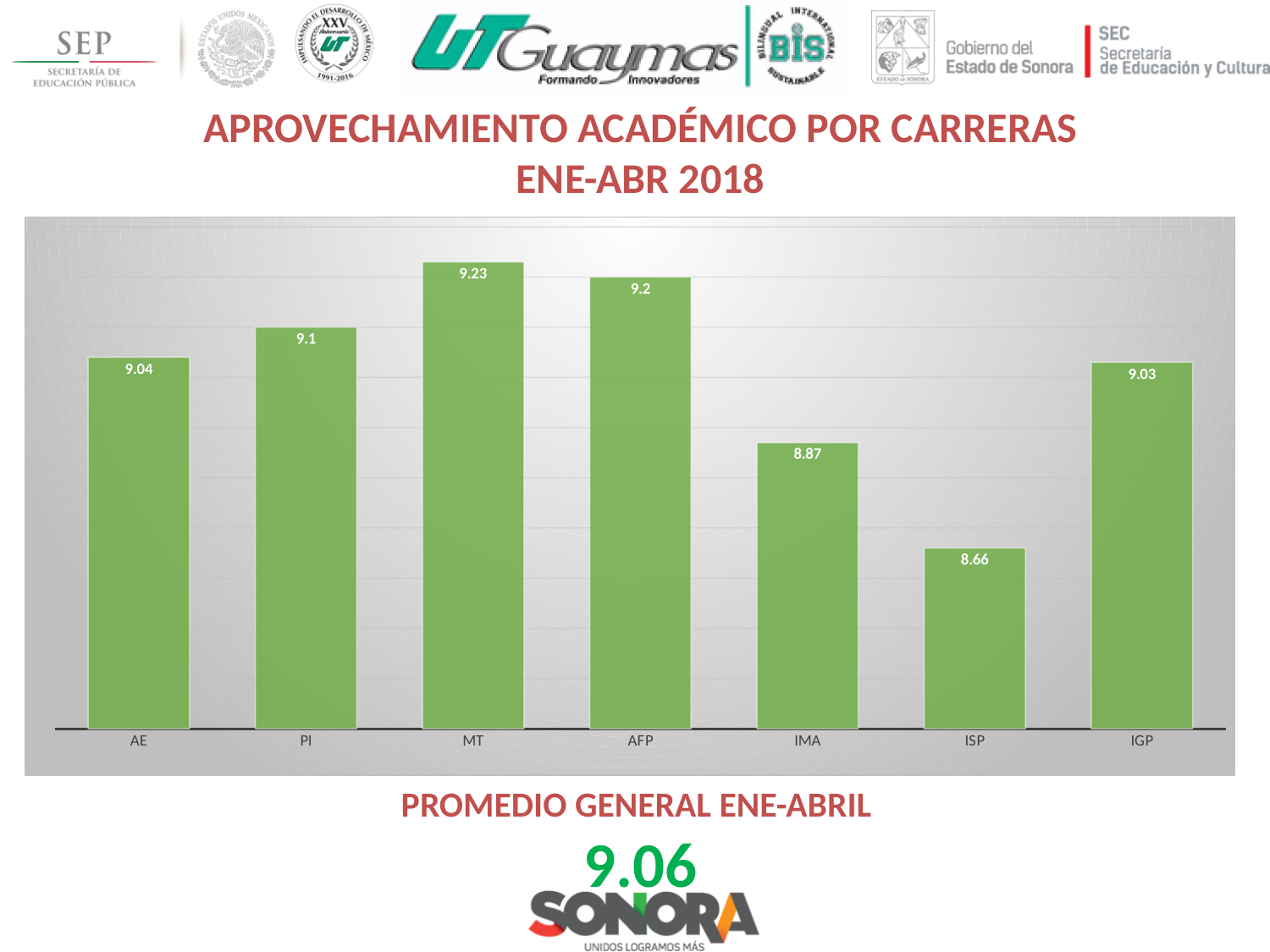
What is the value for IMA? 8.87 Which category has the lowest value? ISP What is the title of the slide above the chart? APROVECHAMIENTO ACADÉMICO POR CARRERAS ENE-ABR 2018 What is the difference between the values for MT and ISP? 0.57 What is the value for IGP? 9.03 What is the value for MT? 9.23 What is the value for ISP? 8.66 What kind of chart is shown on the slide? Bar chart Which is larger, the value for AFP or the value for IMA? AFP Which category has the highest value? MT How many categories are shown on the x axis? 7 What is the difference between the values for PI and AE? 0.06